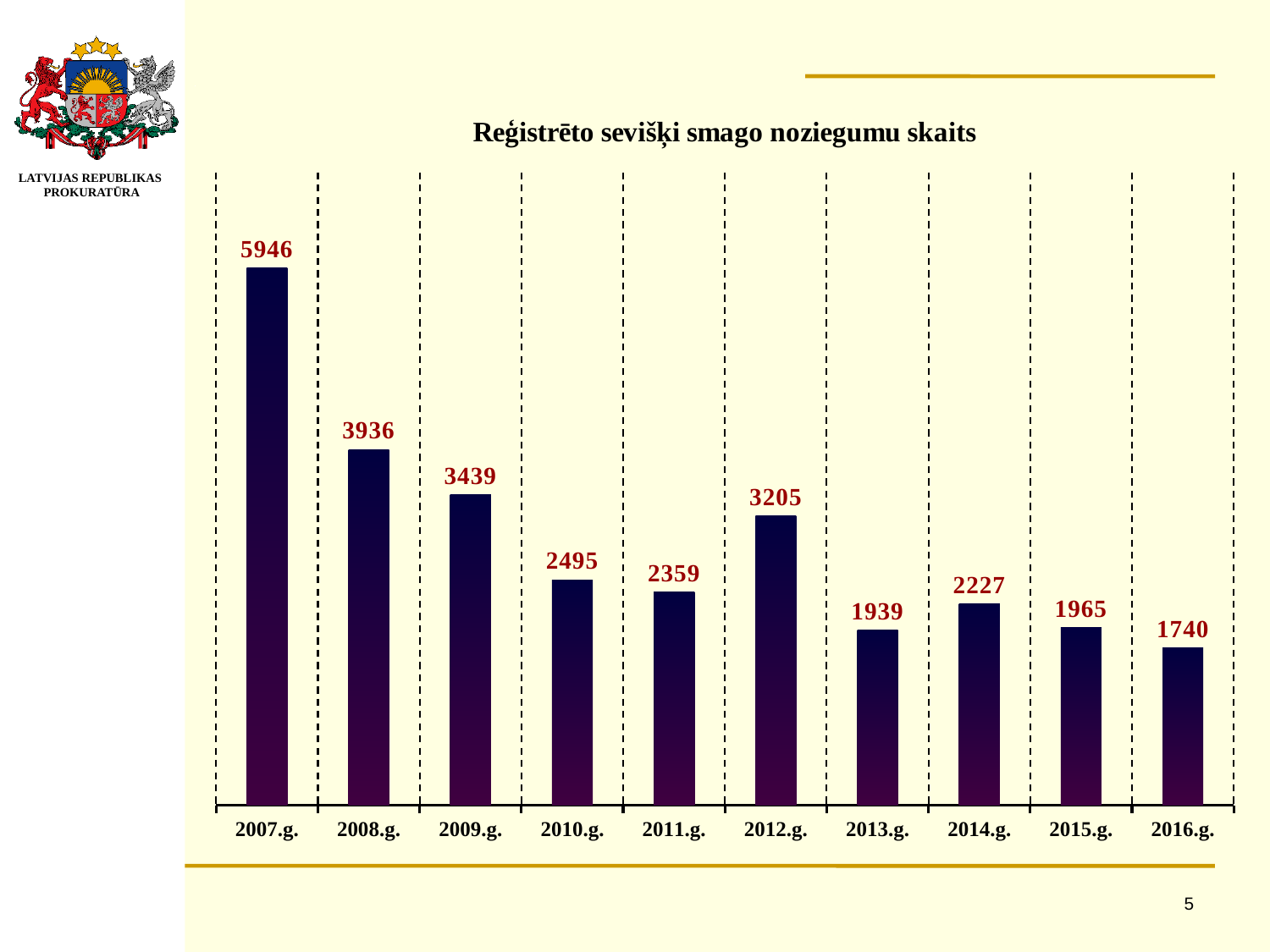
How many years are shown on the x axis? 10 Which is larger, the value for 2011.g. or the value for 2012.g.? 2012.g. What is the value for 2012.g.? 3205 What is the difference between the values for 2007.g. and 2008.g.? 2010 What is the value for 2007.g.? 5946 What kind of chart is this? bar chart What is the difference between the values for 2014.g. and 2013.g.? 288 What is the value for 2016.g.? 1740 Do the values generally rise or fall from 2007.g. to 2016.g.? fall What is the title of the chart? Reģistrēto sevišķi smago noziegumu skaits Which year has the highest value? 2007.g. Which year has the lowest value? 2016.g.